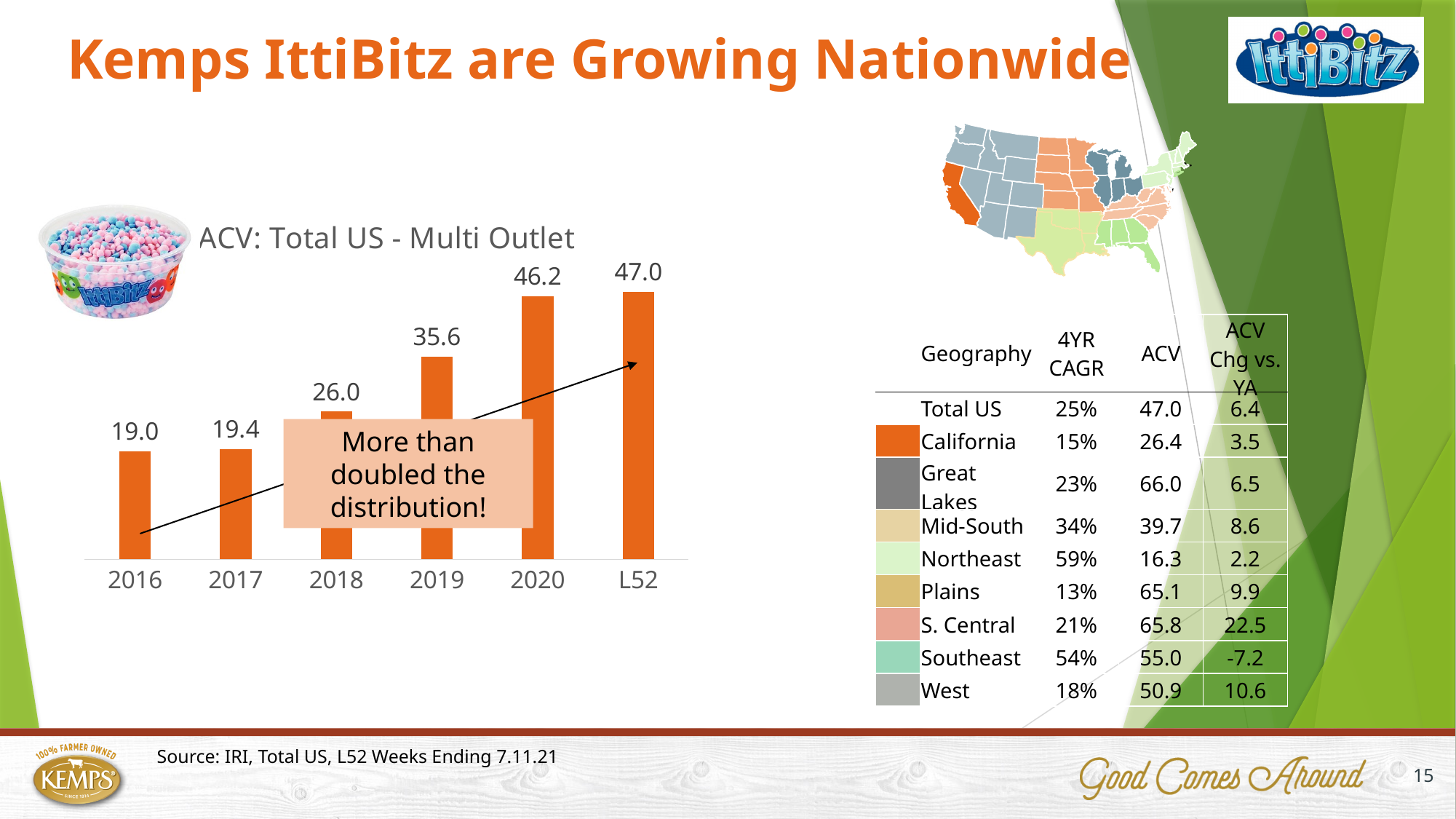
How many categories are shown on the x axis of the ACV: Total US - Multi Outlet chart? 6 What is the ACV value for 2016 in the ACV: Total US - Multi Outlet chart? 19.0 What is the difference between the 2020 and 2019 values in the ACV: Total US - Multi Outlet chart? 10.6 Which is larger in the ACV: Total US - Multi Outlet chart, the value for 2018 or the value for 2019? 2019 Do the values in the ACV: Total US - Multi Outlet chart rise or fall from 2016 to L52? Rise What is the ACV value for 2019 in the ACV: Total US - Multi Outlet chart? 35.6 What kind of chart is the ACV: Total US - Multi Outlet chart? Bar chart Which category has the highest value in the ACV: Total US - Multi Outlet chart? L52 What is the difference between the L52 and 2016 values in the ACV: Total US - Multi Outlet chart? 28.0 What is the ACV value for L52 in the ACV: Total US - Multi Outlet chart? 47.0 What is the title of the bar chart on the slide? ACV: Total US - Multi Outlet Which category has the lowest value in the ACV: Total US - Multi Outlet chart? 2016